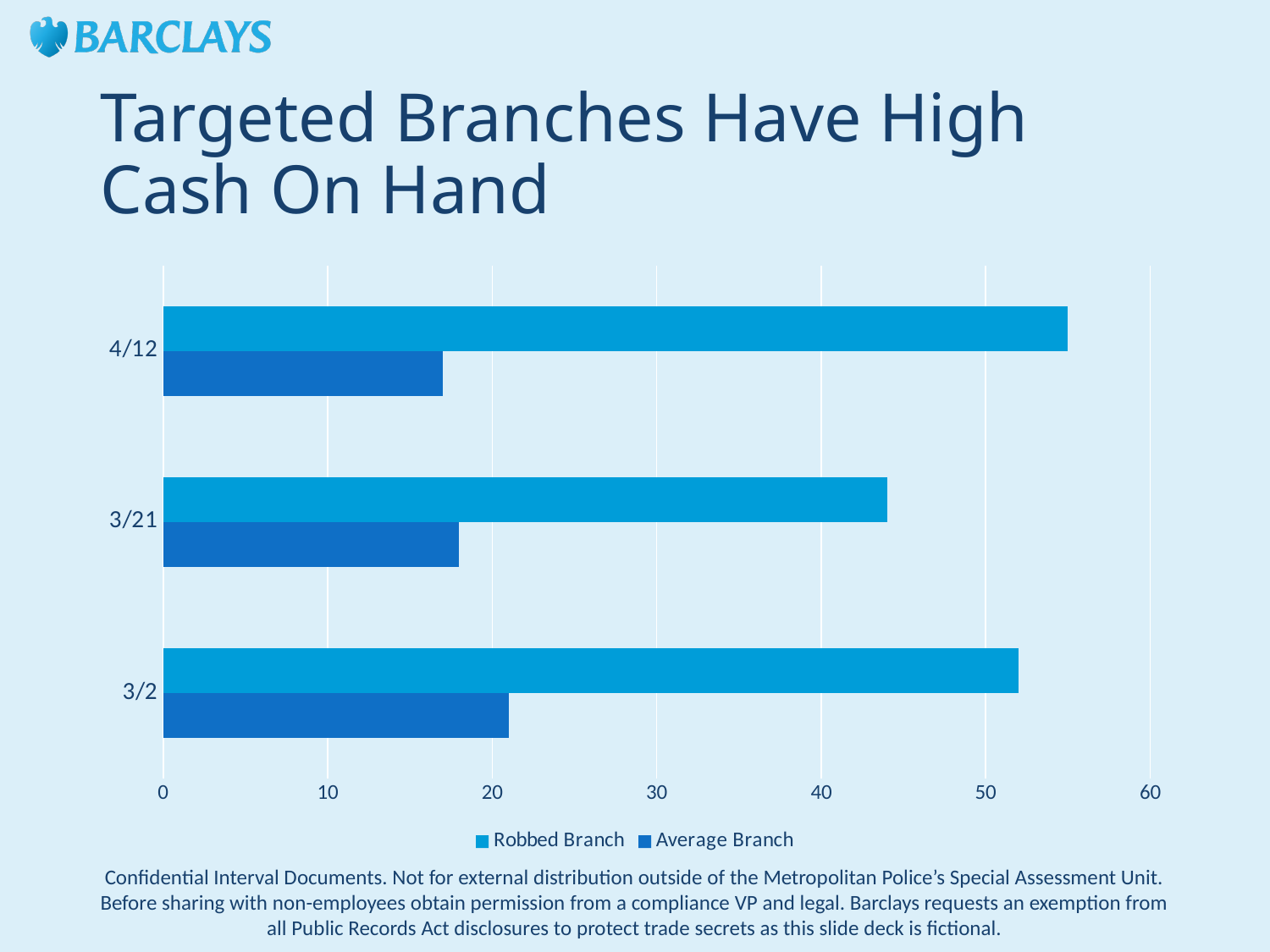
How many series does the legend list? 2 Which series is shown in the darker blue colour? Average Branch Which date has the highest Robbed Branch value? 4/12 Which date has the lowest Robbed Branch value? 3/21 Is the Robbed Branch value for 3/21 greater or less than 50? less Is the Average Branch value for 4/12 greater or less than 20? less For 3/21, which is larger: the Robbed Branch value or the Average Branch value? Robbed Branch Is the Average Branch value for 3/2 greater or less than 30? less How many categories (dates) are shown on the chart? 3 What is the title of the slide containing the chart? Targeted Branches Have High Cash On Hand What kind of chart is shown on the slide? Bar chart